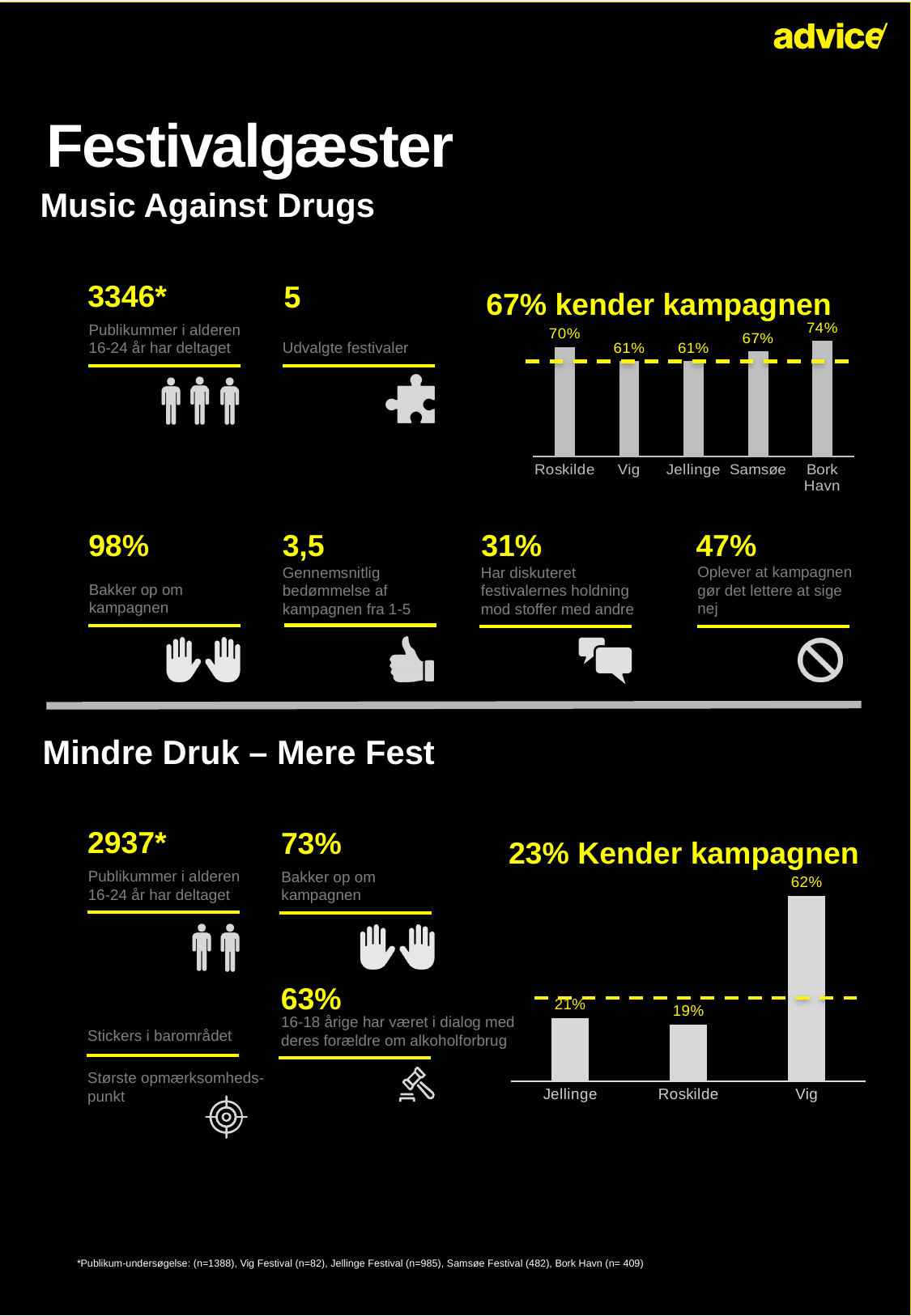
In the "23% Kender kampagnen" chart, what is the difference between Vig and Jellinge? 41% In the "23% Kender kampagnen" chart, what is the value for Roskilde? 19% In the "23% Kender kampagnen" chart, what is the value for Vig? 62% In the "67% kender kampagnen" chart, which festival has the highest value? Bork Havn In the "67% kender kampagnen" chart, what is the value for Bork Havn? 74% In the "67% kender kampagnen" chart, which is larger, Roskilde or Samsøe? Roskilde In the "67% kender kampagnen" chart, how many festivals are shown? 5 In the "23% Kender kampagnen" chart, which festival has the lowest value? Roskilde In the "67% kender kampagnen" chart, what is the value for Roskilde? 70% What type of chart is the "23% Kender kampagnen" chart? Bar chart In the "67% kender kampagnen" chart, what is the difference between Bork Havn and Vig? 13% In the "23% Kender kampagnen" chart, how many festivals are shown? 3